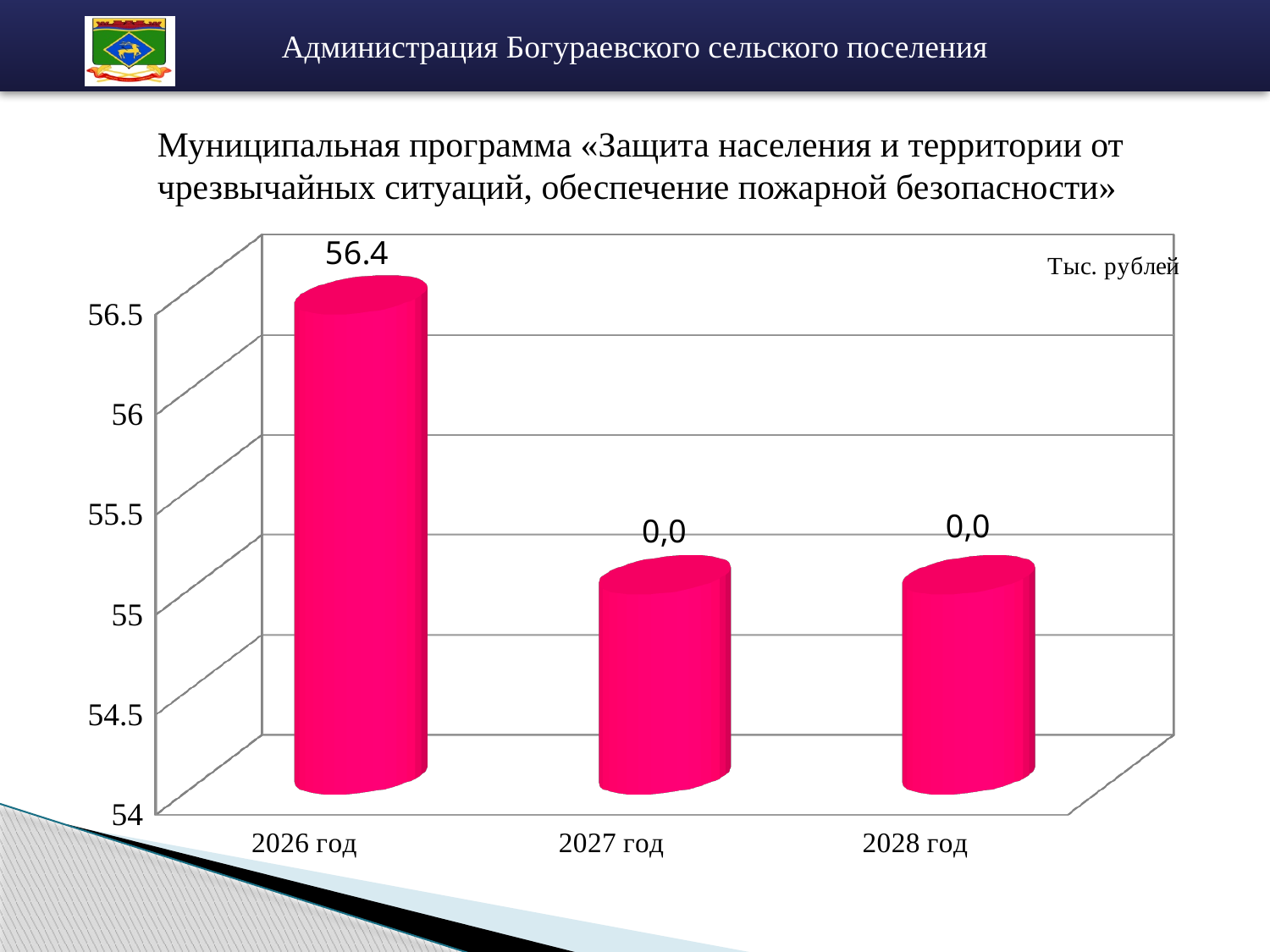
What unit of measurement is indicated on the chart? Тыс. рублей How many years are shown on the chart? 3 What is the name of the municipal programme in the chart title? «Защита населения и территории от чрезвычайных ситуаций, обеспечение пожарной безопасности» What is the value for 2026 год? 56.4 Do the values rise or fall from 2026 год to 2028 год? fall Is the value for 2026 год greater or less than 56? greater What is the value shown for 2027 год? 0,0 Which year has the highest value? 2026 год What kind of chart is this? bar chart What is the value shown for 2028 год? 0,0 Which is larger, the value for 2026 год or the value for 2028 год? 2026 год